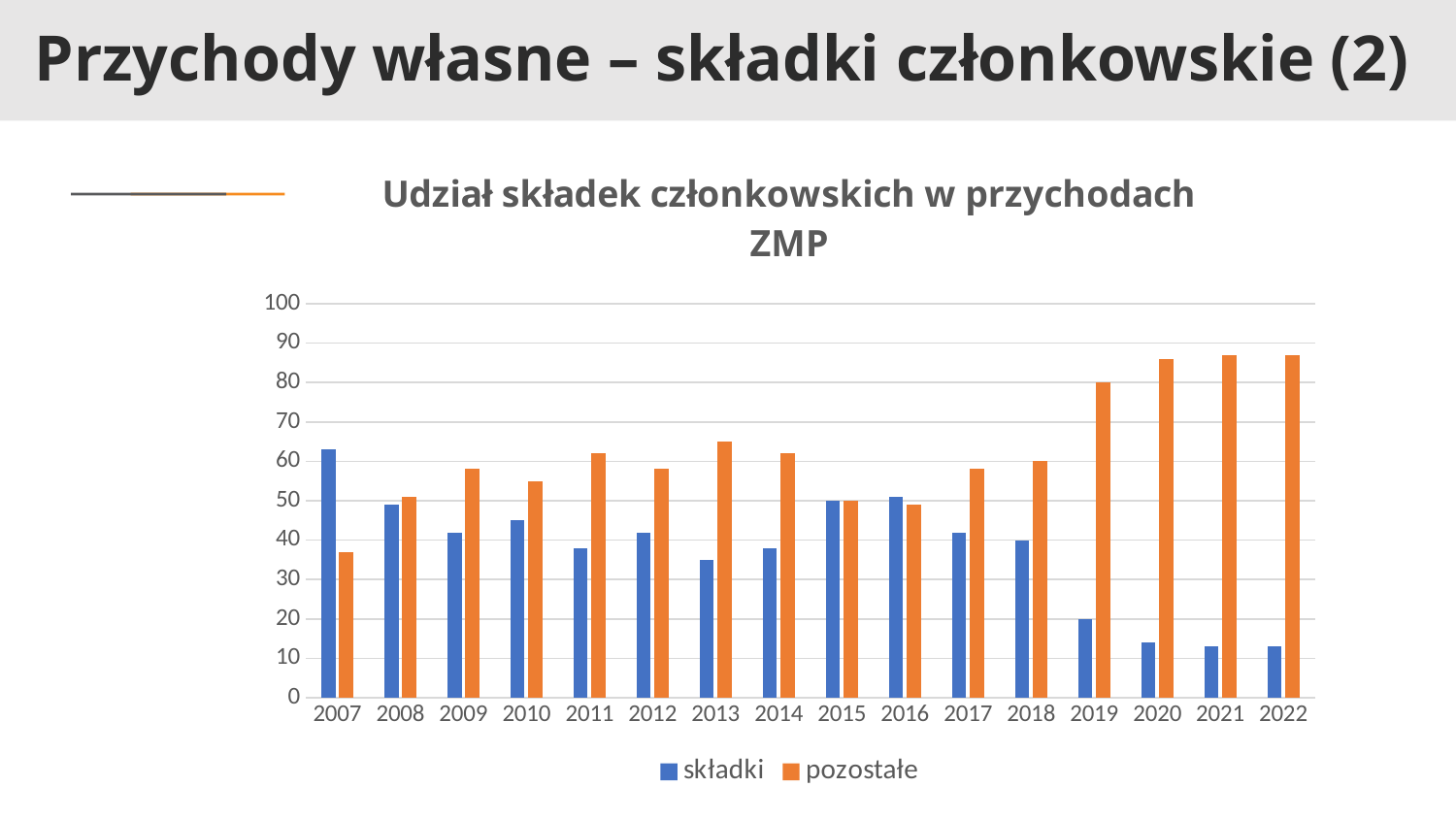
What kind of chart is shown on the slide? bar chart Is the value for pozostałe in 2022 greater or less than 80? greater In 2013, which is larger: składki or pozostałe? pozostałe Is the value for składki in 2021 greater or less than 20? less In 2008, which is larger: składki or pozostałe? pozostałe How many series does the legend list? 2 How many years are shown on the x axis? 16 What is the title of the chart? Udział składek członkowskich w przychodach ZMP Is the value for składki in 2007 greater or less than 60? greater Do the values for składki generally rise or fall from 2016 to 2022? fall Which year has the highest value for składki? 2007 Which year has the lowest value for pozostałe? 2007